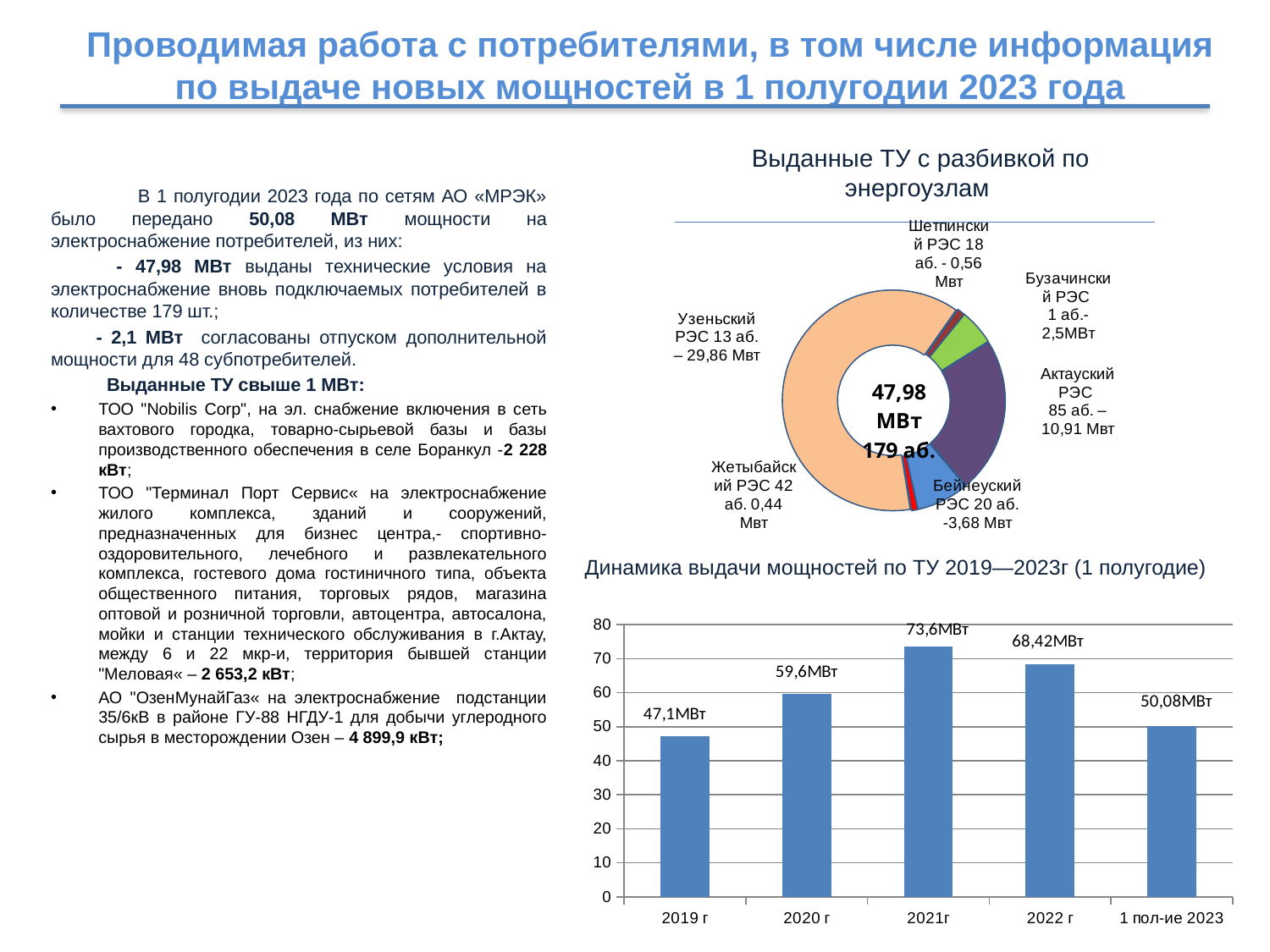
On the doughnut chart 'Выданные ТУ с разбивкой по энергоузлам', what is the value for Актауский РЭС? 10,91 Мвт On the bar chart 'Динамика выдачи мощностей по ТУ 2019—2023г (1 полугодие)', what is the value for 2021г? 73,6МВт On the doughnut chart 'Выданные ТУ с разбивкой по энергоузлам', what is the value for Узеньский РЭС? 29,86 Мвт On the bar chart 'Динамика выдачи мощностей по ТУ 2019—2023г (1 полугодие)', which year has the highest value? 2021г On the bar chart 'Динамика выдачи мощностей по ТУ 2019—2023г (1 полугодие)', do the values rise or fall from 2019 г to 2021г? Rise On the bar chart 'Динамика выдачи мощностей по ТУ 2019—2023г (1 полугодие)', which is larger: the value for 2022 г or the value for 1 пол-ие 2023? 2022 г What kind of chart is 'Динамика выдачи мощностей по ТУ 2019—2023г (1 полугодие)'? Bar chart On the bar chart 'Динамика выдачи мощностей по ТУ 2019—2023г (1 полугодие)', how many bars are plotted? 5 On the doughnut chart 'Выданные ТУ с разбивкой по энергоузлам', what total value is shown in the centre of the chart? 47,98 МВт On the bar chart 'Динамика выдачи мощностей по ТУ 2019—2023г (1 полугодие)', which category has the lowest value? 2019 г On the bar chart 'Динамика выдачи мощностей по ТУ 2019—2023г (1 полугодие)', what is the difference between the values for 2020 г and 2019 г? 12,5МВт On the bar chart 'Динамика выдачи мощностей по ТУ 2019—2023г (1 полугодие)', what is the value for 1 пол-ие 2023? 50,08МВт